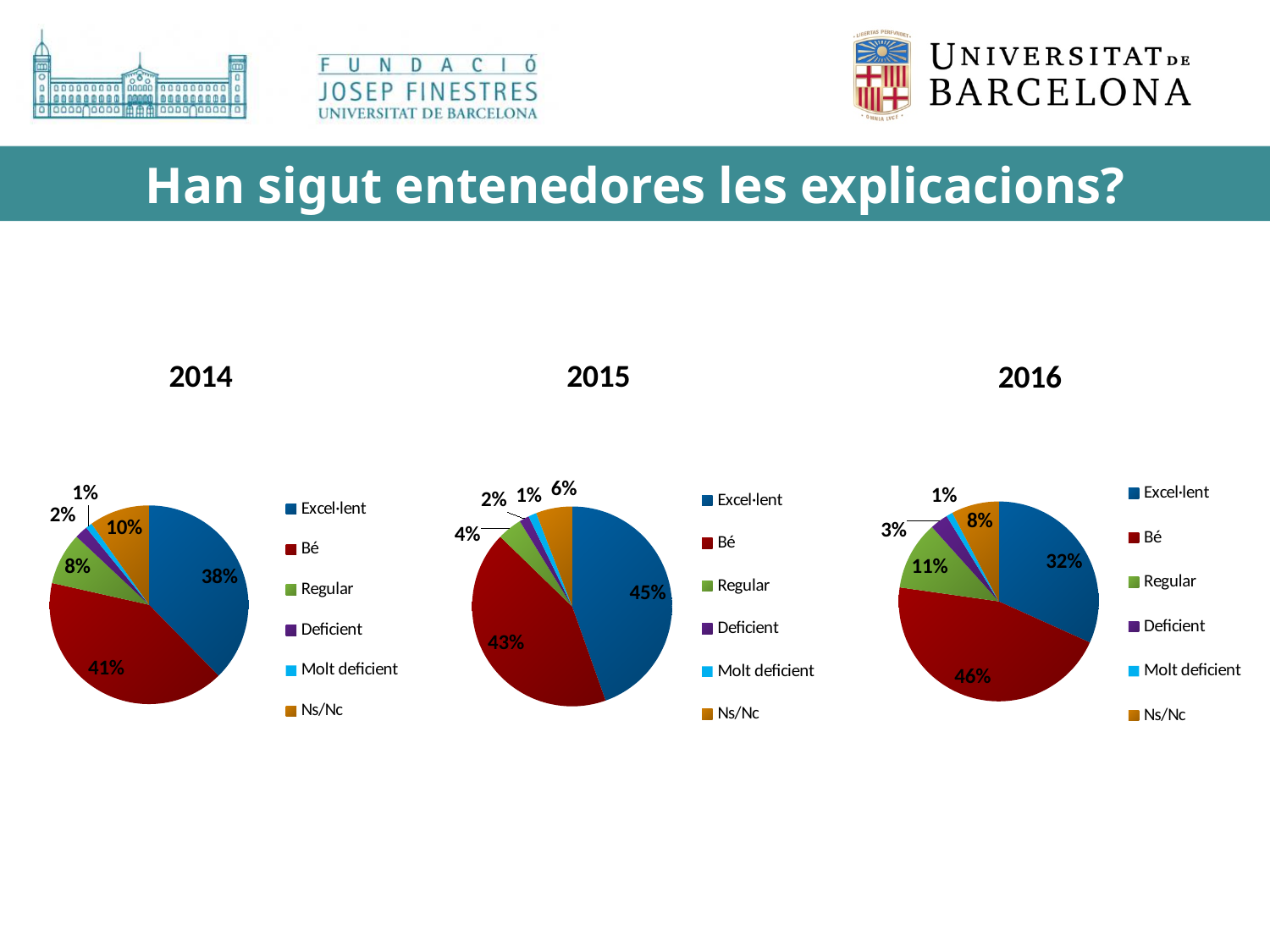
What type of chart is used for the 2014 data? Pie chart In the 2015 chart, what percentage is shown for Bé? 43% In the 2016 chart, what percentage is shown for Regular? 11% In the 2014 chart, what is the difference between the Bé and Excel·lent percentages? 3% In the 2016 chart, which category has the largest slice? Bé In the 2016 chart, which is larger, Ns/Nc or Regular? Regular In the 2014 chart, which category has the smallest slice? Molt deficient How many categories does the legend of the 2015 chart list? 6 In the 2015 chart, which category has the largest slice? Excel·lent In the 2014 chart, what percentage is shown for Excel·lent? 38% How many pie charts are shown on the slide? 3 In the 2015 chart, what percentage is shown for Ns/Nc? 6%